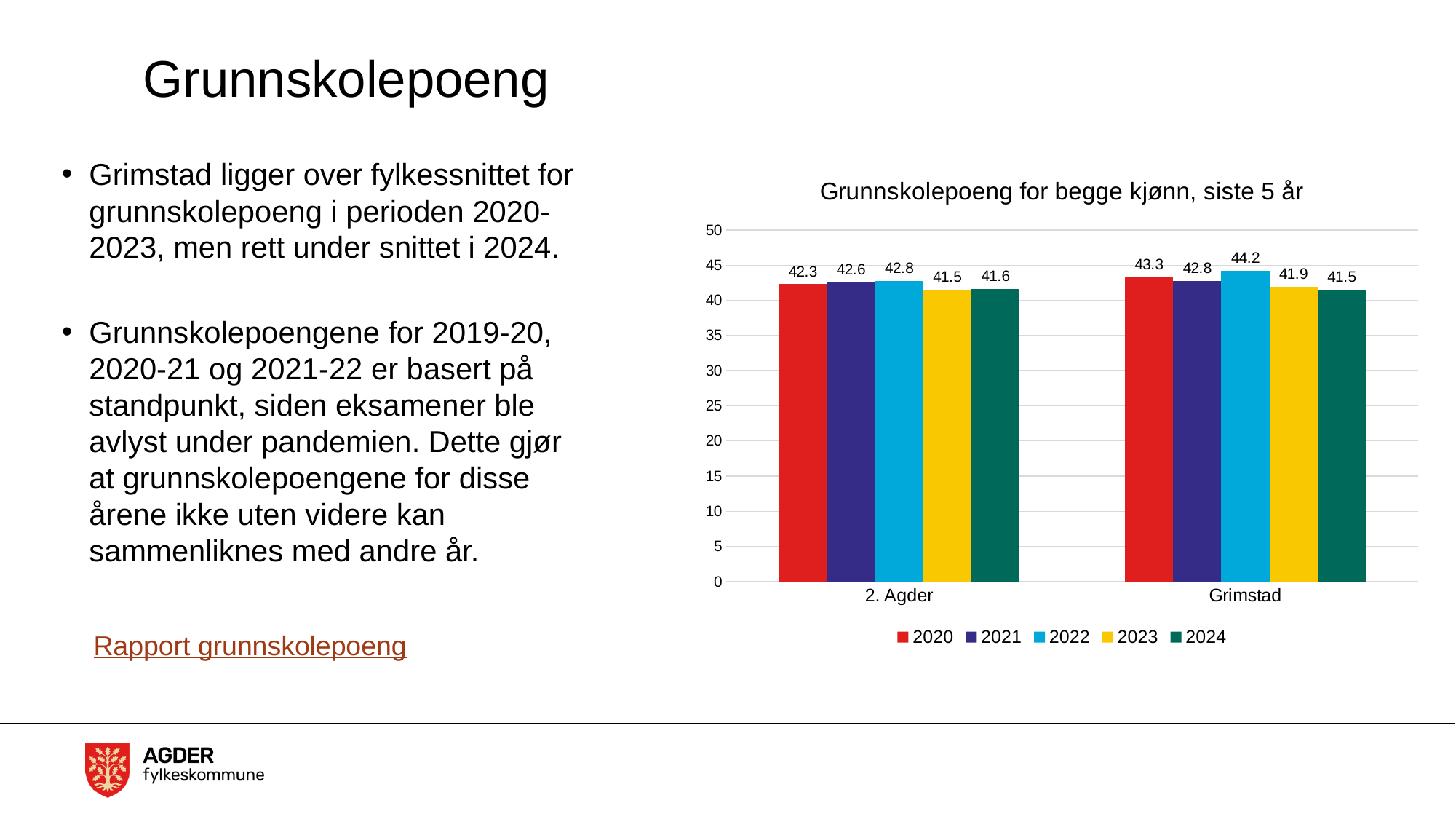
Which is larger in 2024: the value for 2. Agder or for Grimstad? 2. Agder How many categories are shown on the x axis? 2 What is the value for Grimstad in 2024? 41.5 What is the value for 2. Agder in 2020? 42.3 Which year has the lowest value for 2. Agder? 2023 What is the difference between the Grimstad and 2. Agder values in 2022? 1.4 What is the value for 2. Agder in 2023? 41.5 How many series does the legend list? 5 What kind of chart is shown on the slide? Bar chart What is the value for Grimstad in 2022? 44.2 Which year has the highest value for Grimstad? 2022 What is the title of the chart? Grunnskolepoeng for begge kjønn, siste 5 år